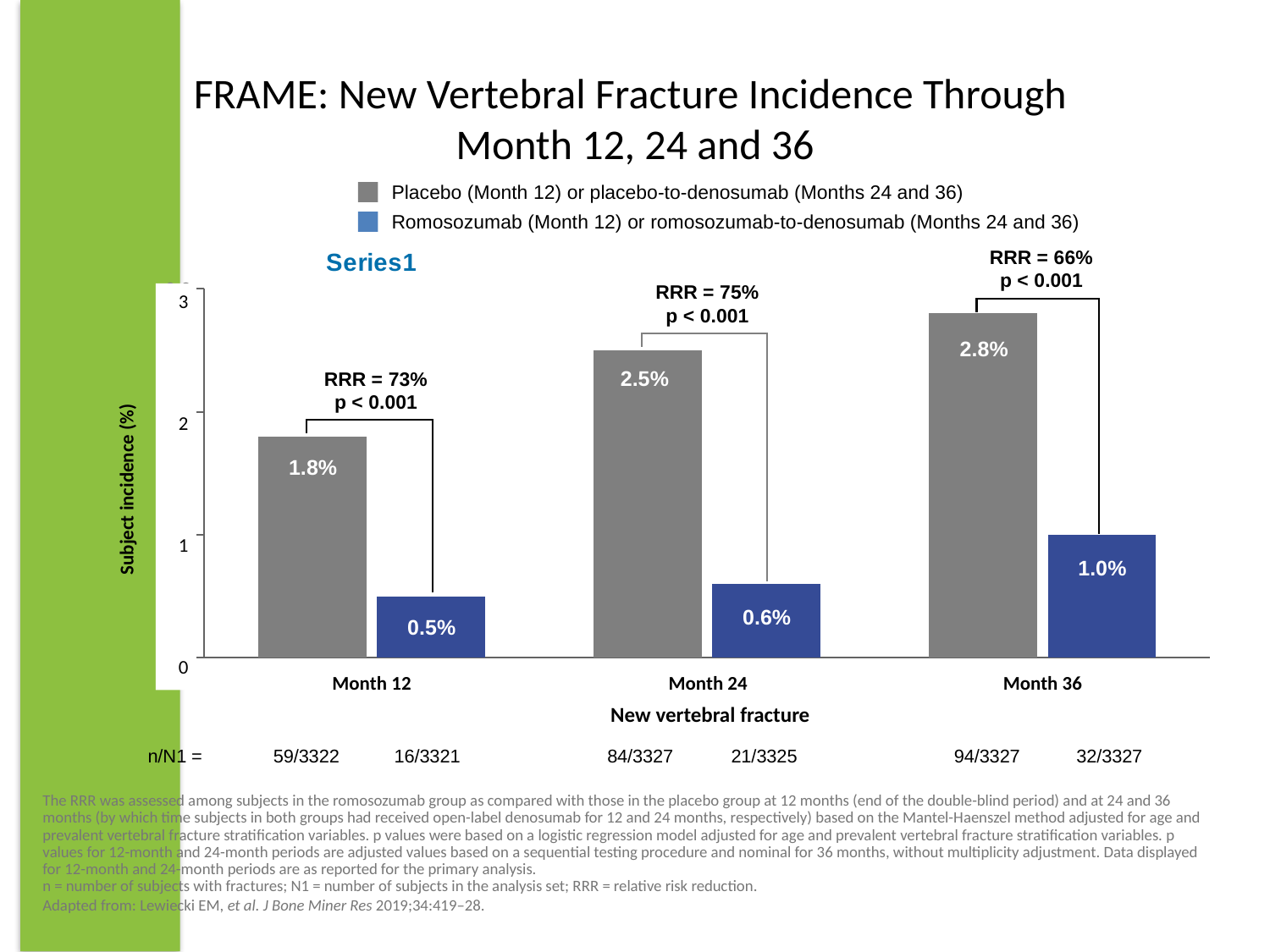
What is the subject incidence for the romosozumab group at Month 24? 0.6% Is the placebo incidence at Month 24 greater or less than 2? greater What is the difference between the placebo and romosozumab incidence at Month 24? 1.9% How many time points (categories) are shown on the x axis? 3 At which month is the romosozumab (or romosozumab-to-denosumab) incidence lowest? Month 12 How many series does the legend list? 2 At which month is the placebo (or placebo-to-denosumab) incidence highest? Month 36 Does the romosozumab (or romosozumab-to-denosumab) incidence rise or fall from Month 12 to Month 36? Rise What is the subject incidence for the placebo group at Month 12? 1.8% What is the subject incidence for the placebo-to-denosumab group at Month 36? 2.8% What kind of chart is shown on the slide? Bar chart Which is larger at Month 36: the placebo-to-denosumab incidence or the romosozumab-to-denosumab incidence? Placebo-to-denosumab